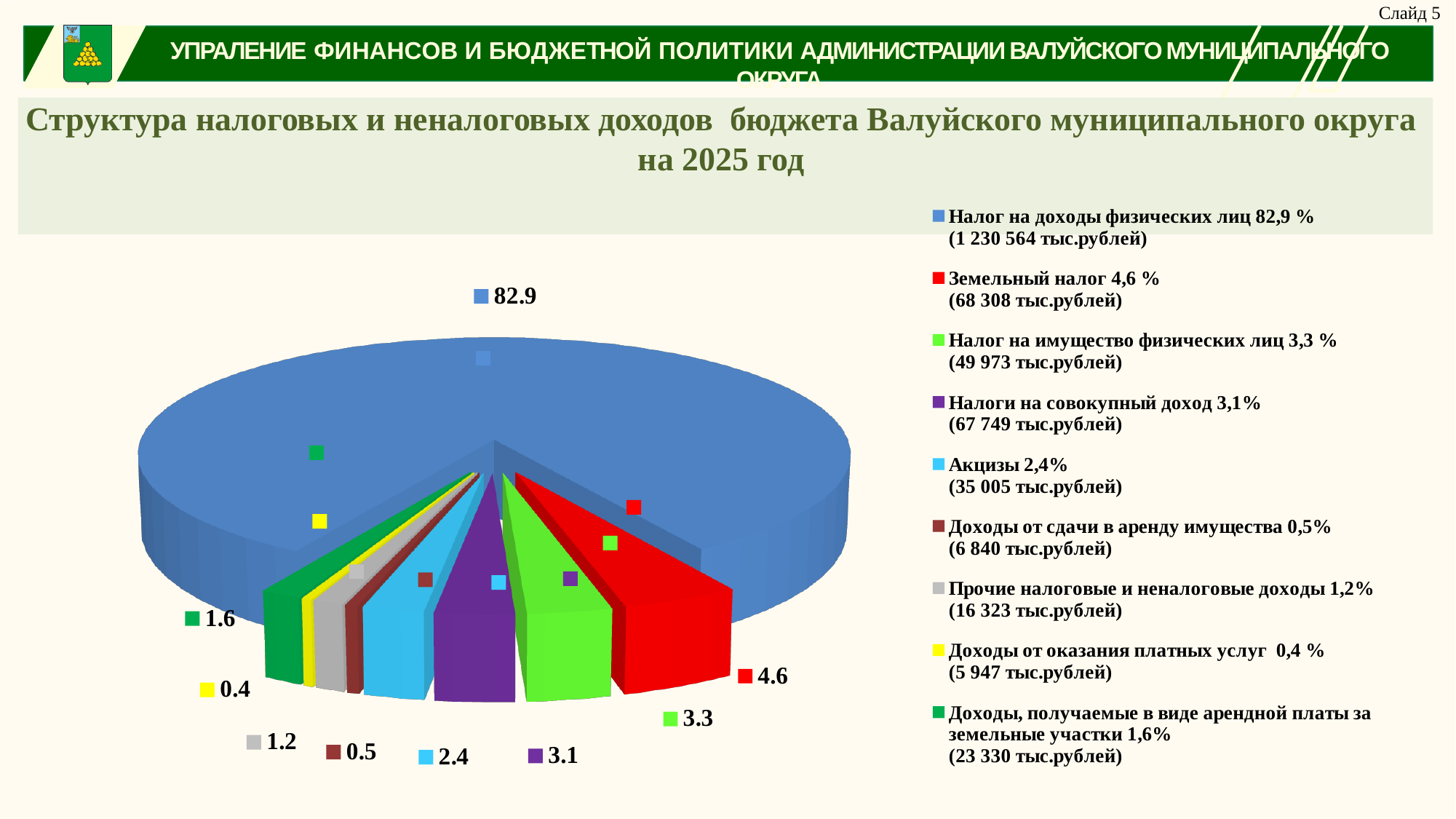
What kind of chart is shown on the slide? pie chart Which is larger: the slice for Акцизы or the slice for Налоги на совокупный доход? Налоги на совокупный доход Which category has the largest slice of the pie? Налог на доходы физических лиц How many slices does the pie chart have? 9 What is the title of the chart on the slide? Структура налоговых и неналоговых доходов бюджета Валуйского муниципального округа на 2025 год What value is labelled on the pie slice for Налог на доходы физических лиц? 82.9 Which category has the smallest slice of the pie? Доходы от оказания платных услуг What share of the pie does Налог на имущество физических лиц represent, as labelled on the chart? 3.3 What is the difference between the labelled values for Земельный налог and Налог на имущество физических лиц? 1.3 According to the legend, what amount in thousand rubles corresponds to Акцизы? 35 005 тыс.рублей What is the difference between the labelled values for Доходы, получаемые в виде арендной платы за земельные участки and Прочие налоговые и неналоговые доходы? 0.4 What value is labelled on the pie slice for Земельный налог? 4.6